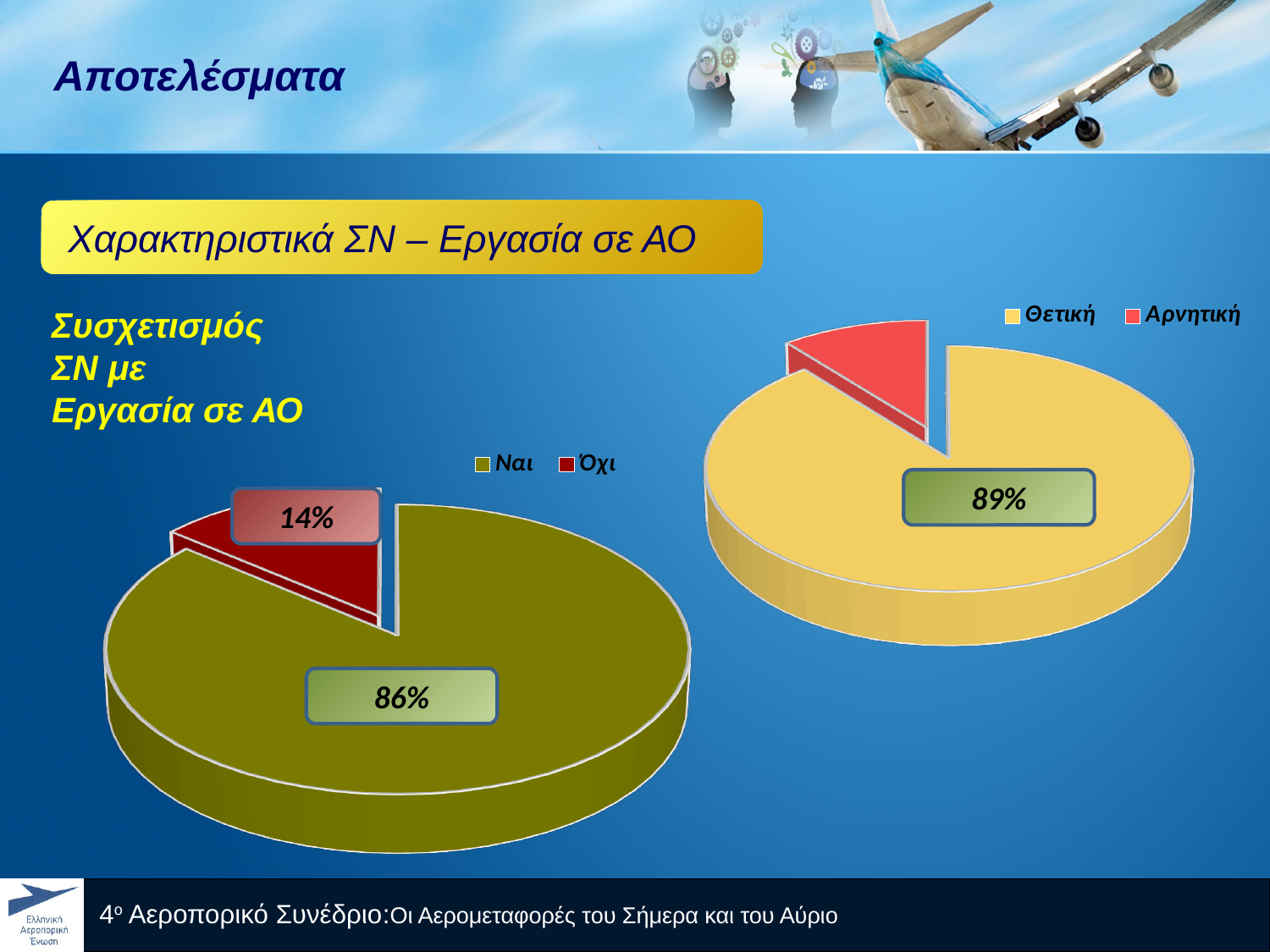
In the right pie chart, which category has the largest slice? Θετική In the left pie chart, what is the value for Όχι? 14% What kind of chart is the left chart? Pie chart In the right pie chart, which is larger, Θετική or Αρνητική? Θετική In the right pie chart, which category has the smallest slice? Αρνητική In the left pie chart, which category has the largest slice? Ναι In the left pie chart, what is the value for Ναι? 86% How many entries does the legend of the right chart list? 2 In the left pie chart, what colour is the Όχι slice? Dark red In the left pie chart, which category has the smallest slice? Όχι In the left pie chart, what is the difference between the values for Ναι and Όχι? 72% In the right pie chart, what is the value for Θετική? 89%